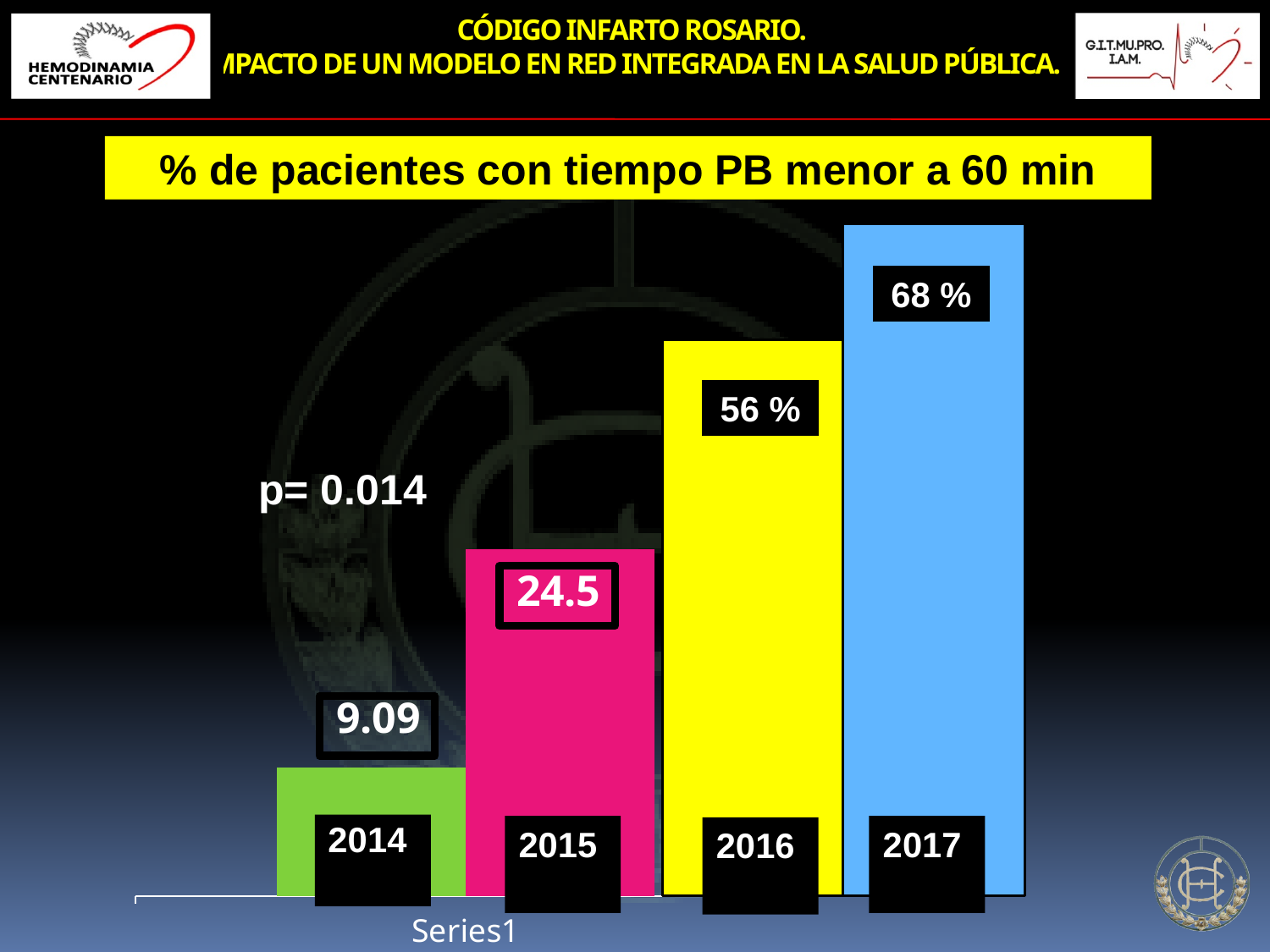
Which year has the highest value? 2017 What is the title of the chart? % de pacientes con tiempo PB menor a 60 min Which year has the lowest value? 2014 Which is larger, the value for 2015 or the value for 2016? 2016 What is the value shown for 2017? 68 % What is the difference between the values for 2017 and 2016? 12 % How many years are shown in the chart? 4 Do the values rise or fall from 2014 to 2017? Rise What is the value shown for 2015? 24.5 What kind of chart is shown on the slide? Bar chart What is the value shown for 2016? 56 % What is the value shown for 2014? 9.09